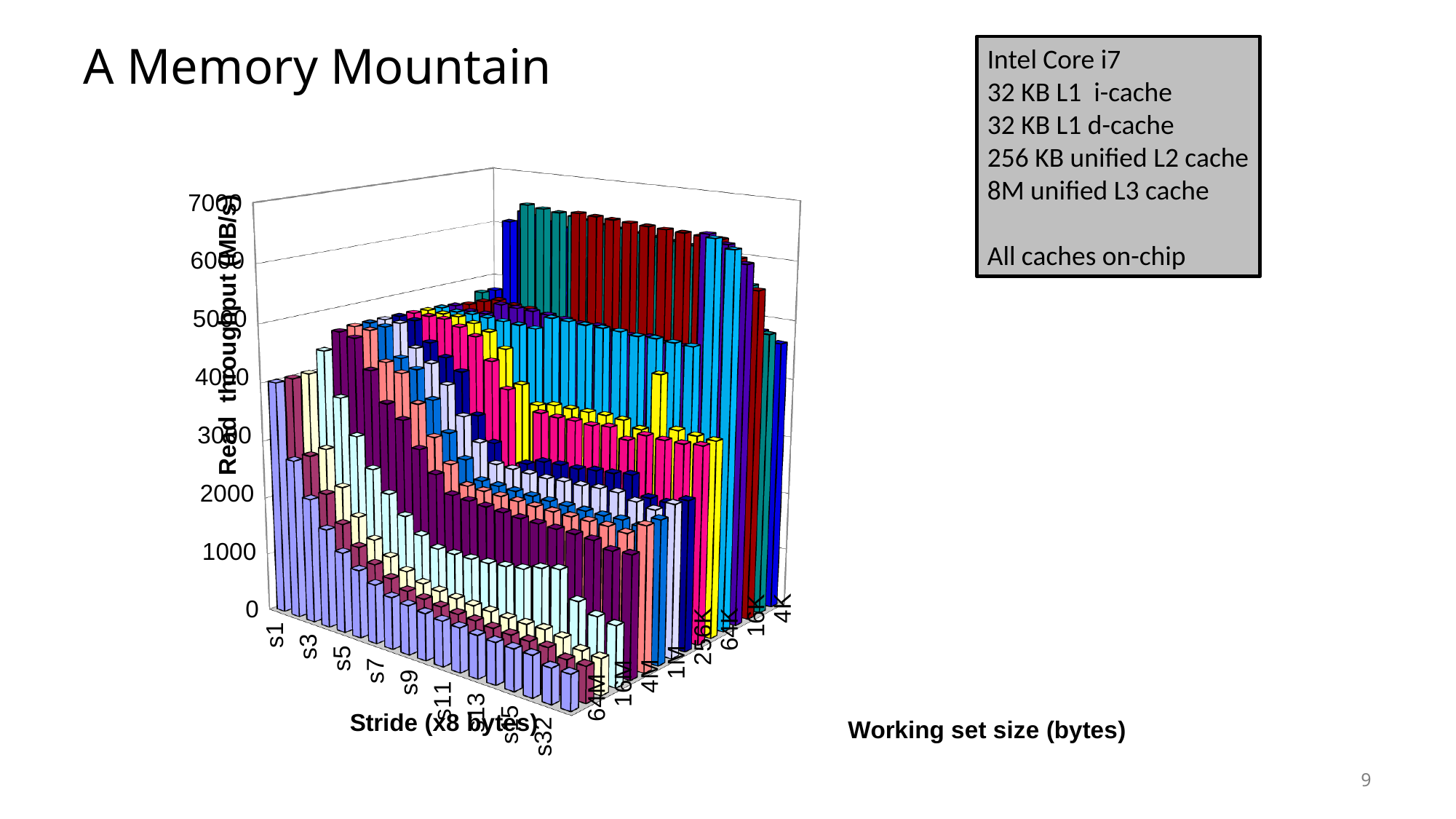
What is the highest tick value shown on the vertical axis? 7000 Are the shortest bars in the front row (large strides at 64M working set) greater or less than 2000 MB/s? less What is the smallest working set size labelled on the chart? 4K What quantity does the vertical axis of the chart measure? Read throughput (MB/s) For the 64M working set, does read throughput rise or fall as the stride increases from s1 to s32? fall Does read throughput generally rise or fall as the working set size grows from 4K to 64M? fall How many working set size labels are shown along the depth axis? 8 What kind of chart is shown on the slide? bar chart What is the largest stride labelled on the chart? s32 Is the tallest bar in the chart greater or less than 6000 MB/s? greater